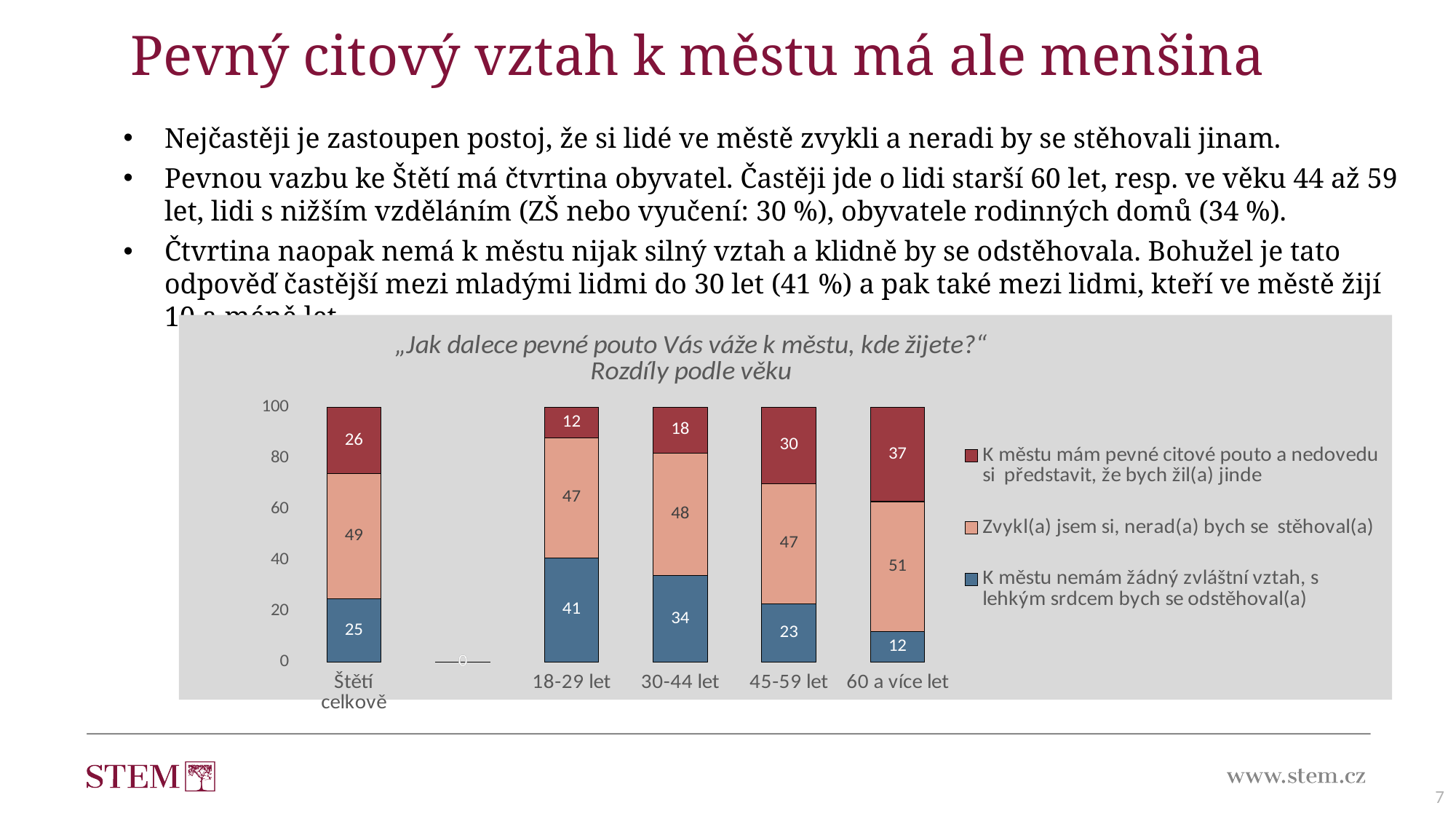
What is the total of the stacked bar for 30-44 let? 100 What is the value for "K městu mám pevné citové pouto a nedovedu si představit, že bych žil(a) jinde" in the 60 a více let group? 37 Which age group has the lowest value for "K městu nemám žádný zvláštní vztah, s lehkým srdcem bych se odstěhoval(a)"? 60 a více let How does the value for "K městu mám pevné citové pouto" change across the age groups from 18-29 let to 60 a více let? It rises Which is larger: the "K městu mám pevné citové pouto" value for 30-44 let or for 45-59 let? 45-59 let What is the value for "K městu nemám žádný zvláštní vztah, s lehkým srdcem bych se odstěhoval(a)" in the 18-29 let group? 41 What is the value for "Zvykl(a) jsem si, nerad(a) bych se stěhoval(a)" for Štětí celkově? 49 What kind of chart is shown on the slide? Stacked bar chart Which age group has the highest value for "K městu mám pevné citové pouto a nedovedu si představit, že bych žil(a) jinde"? 60 a více let What is the subtitle of the chart below the question text? Rozdíly podle věku How many series does the legend list? 3 What is the difference between the "K městu nemám žádný zvláštní vztah" values for 18-29 let and 60 a více let? 29